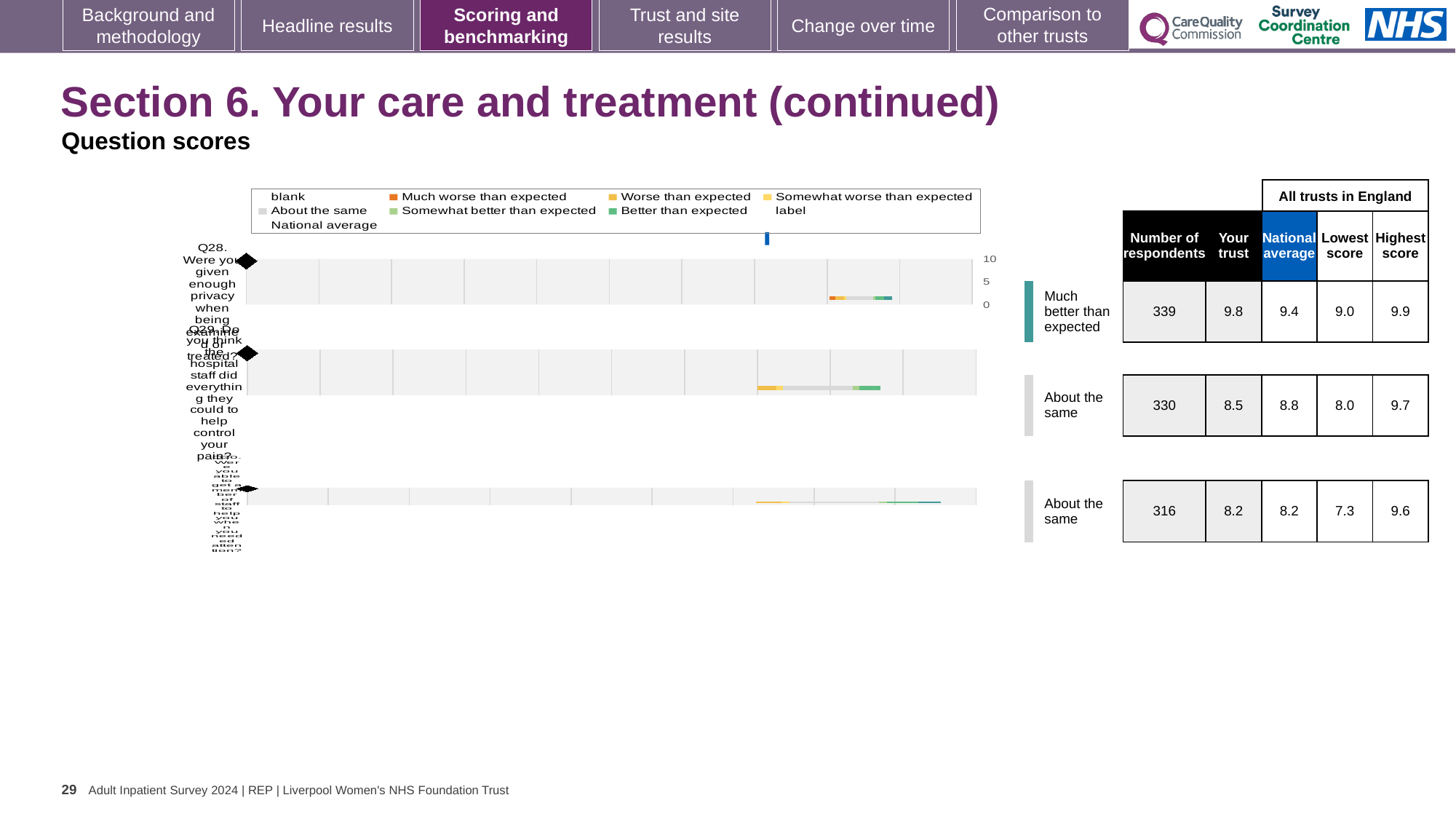
How many questions (rows) are plotted in the question scores chart? 3 Which question has the fewest respondents? Q30 What is the difference between the highest score and the lowest score for Q28? 0.9 What kind of chart is used to show the question scores on this slide? bar chart What benchmark category is shown next to Q28's bar? Much better than expected What is the national average score for Q29 (Do you think the hospital staff did everything they could to help control your pain?)? 8.8 Which question has the highest 'Your trust' score? Q28 What is the 'Your trust' score for Q28 (Were you given enough privacy when being examined or treated?)? 9.8 How many respondents answered Q30? 316 What is the lowest score among all trusts in England for Q30? 7.3 Is the 'Your trust' score for Q28 greater or less than 5 on the chart axis? greater For Q29, which is larger: the 'Your trust' score or the national average? National average